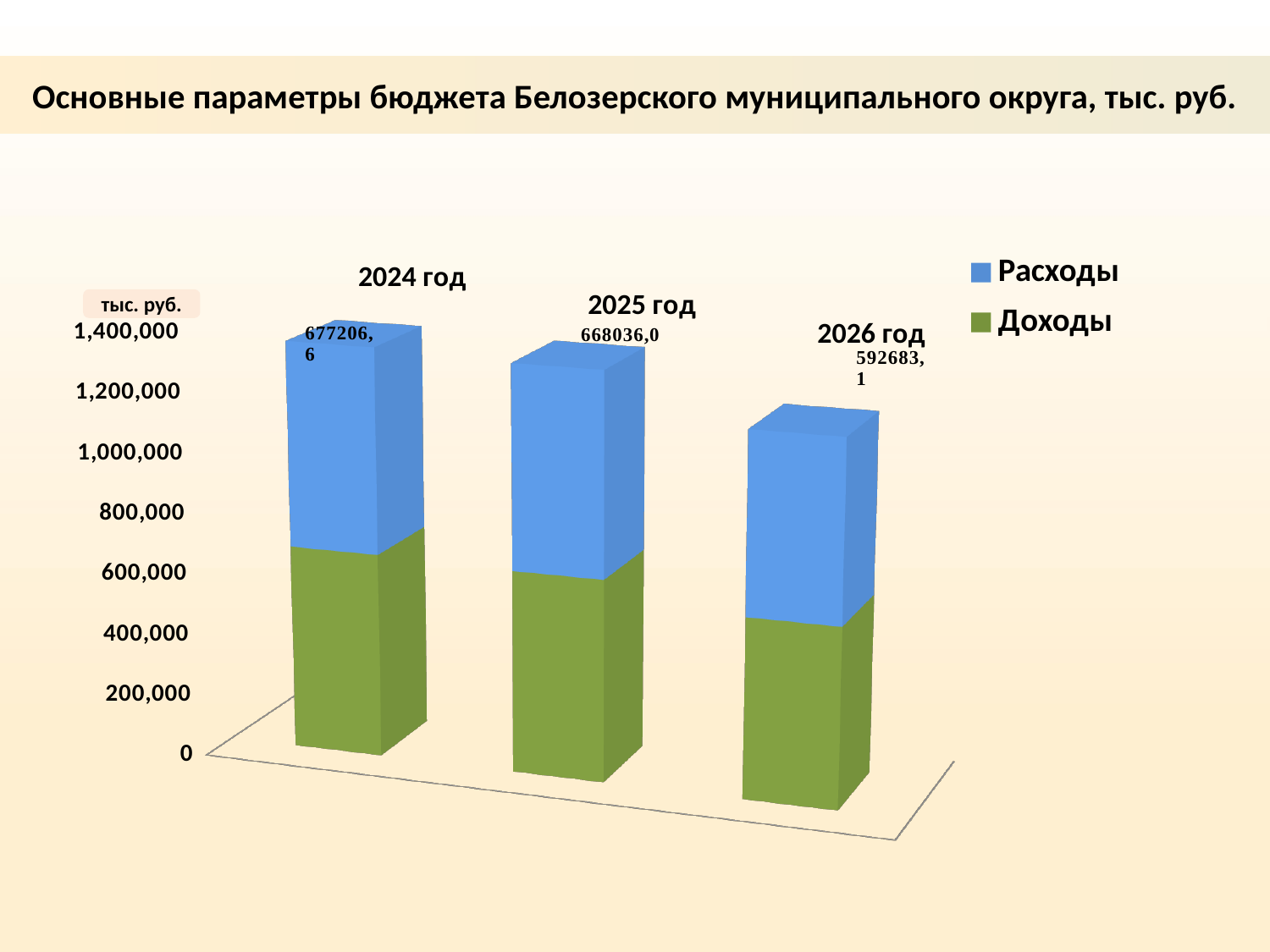
What is the labelled value for Расходы in 2024 год? 677206,6 Do the labelled Расходы values rise or fall from 2024 год to 2026 год? fall What kind of chart is shown on the slide? Stacked bar chart What is the difference between the labelled Расходы values for 2025 год and 2026 год? 75352,9 What is the labelled value for Расходы in 2025 год? 668036,0 How many years (categories) are shown on the chart? 3 Which year has the highest labelled Расходы value? 2024 год Which year has the lowest labelled Расходы value? 2026 год What is the labelled value for Расходы in 2026 год? 592683,1 Which colour represents Доходы in the legend? Green Is the total height of the stacked bar for 2024 год greater or less than 1,200,000? greater How many series does the legend list? 2